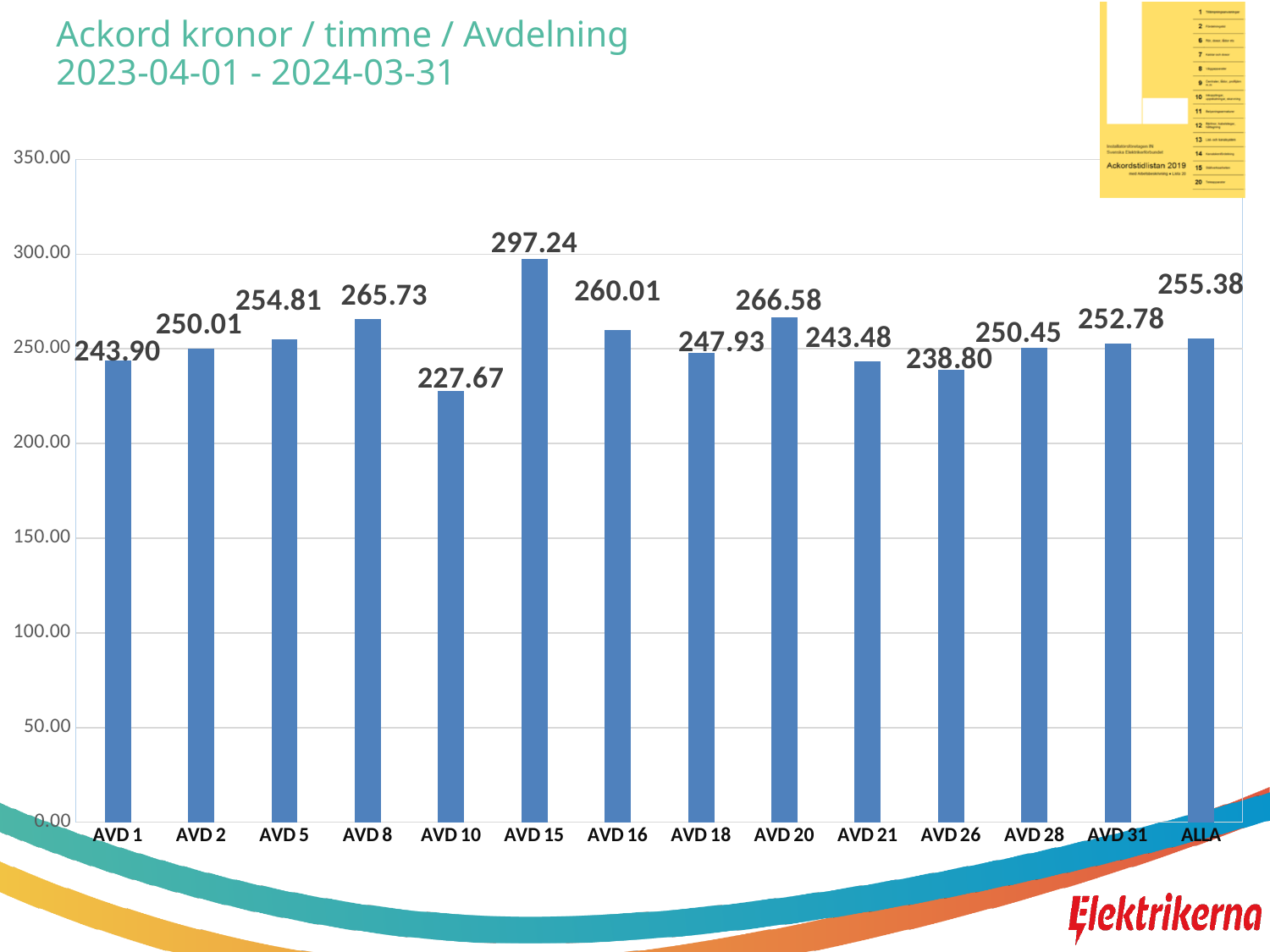
Is the value for AVD 15 greater or less than 250.00? greater Which category has the lowest value? AVD 10 What kind of chart is shown on the slide? bar chart Which is larger, the value for AVD 16 or the value for AVD 21? AVD 16 What is the value for AVD 26? 238.80 What is the value for AVD 10? 227.67 What is the difference between the values for AVD 15 and AVD 10? 69.57 What is the value for ALLA? 255.38 What is the value for AVD 15? 297.24 Which category has the highest value? AVD 15 How many categories are shown on the x axis? 14 What is the title of the chart? Ackord kronor / timme / Avdelning 2023-04-01 - 2024-03-31